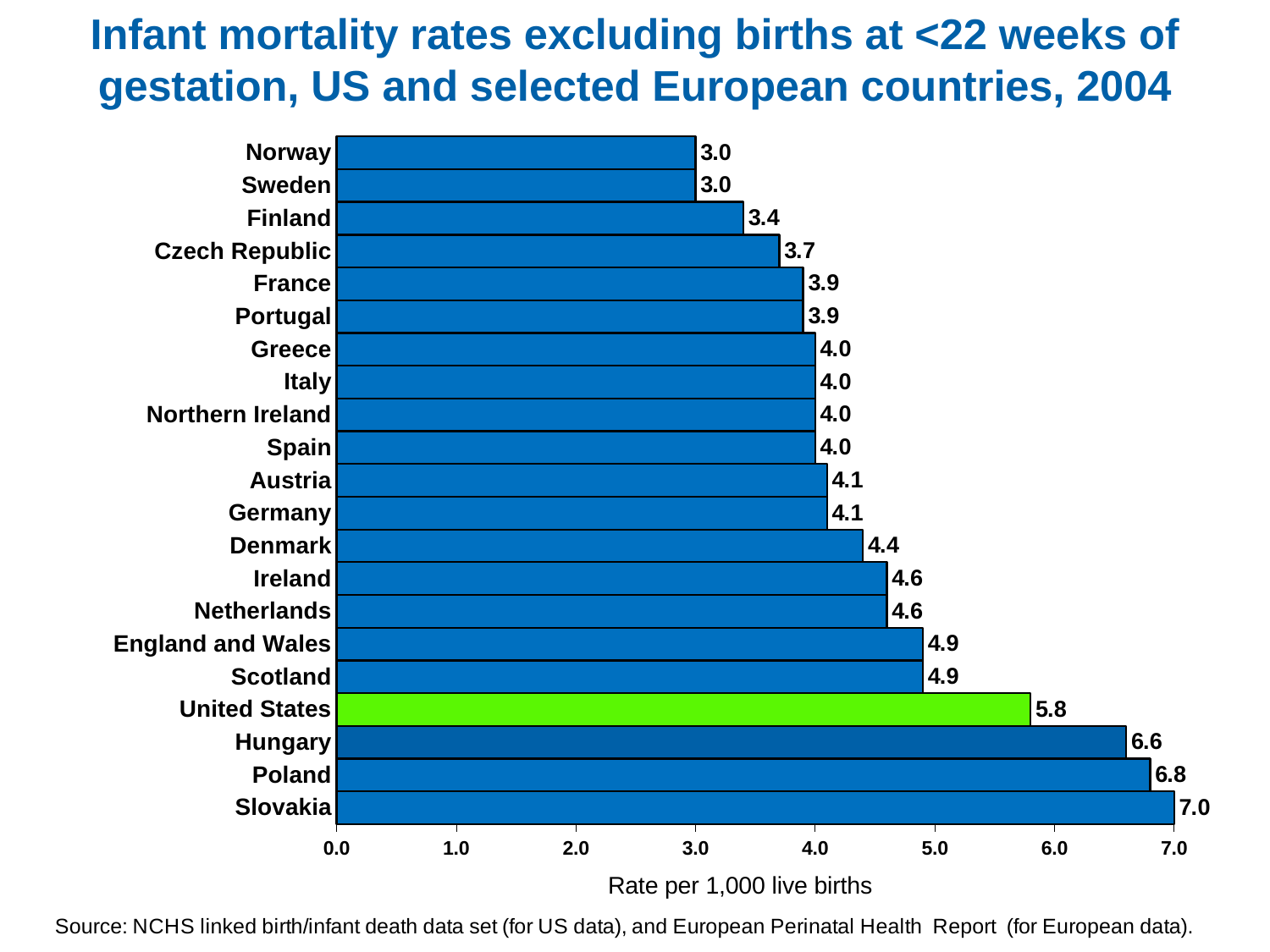
Which has a higher infant mortality rate, Denmark or Czech Republic? Denmark What is the difference between the infant mortality rates of the United States and Scotland? 0.9 How many countries are shown on the chart? 21 What is the infant mortality rate for Finland? 3.4 What is the infant mortality rate for Hungary? 6.6 Is the value for Poland greater or less than 6.0? greater What kind of chart is shown on the slide? Bar chart Which country has the highest infant mortality rate on the chart? Slovakia Which country's bar is coloured green? United States What is the label of the horizontal axis? Rate per 1,000 live births What is the infant mortality rate for the United States? 5.8 What is the difference between the infant mortality rates of Slovakia and Norway? 4.0